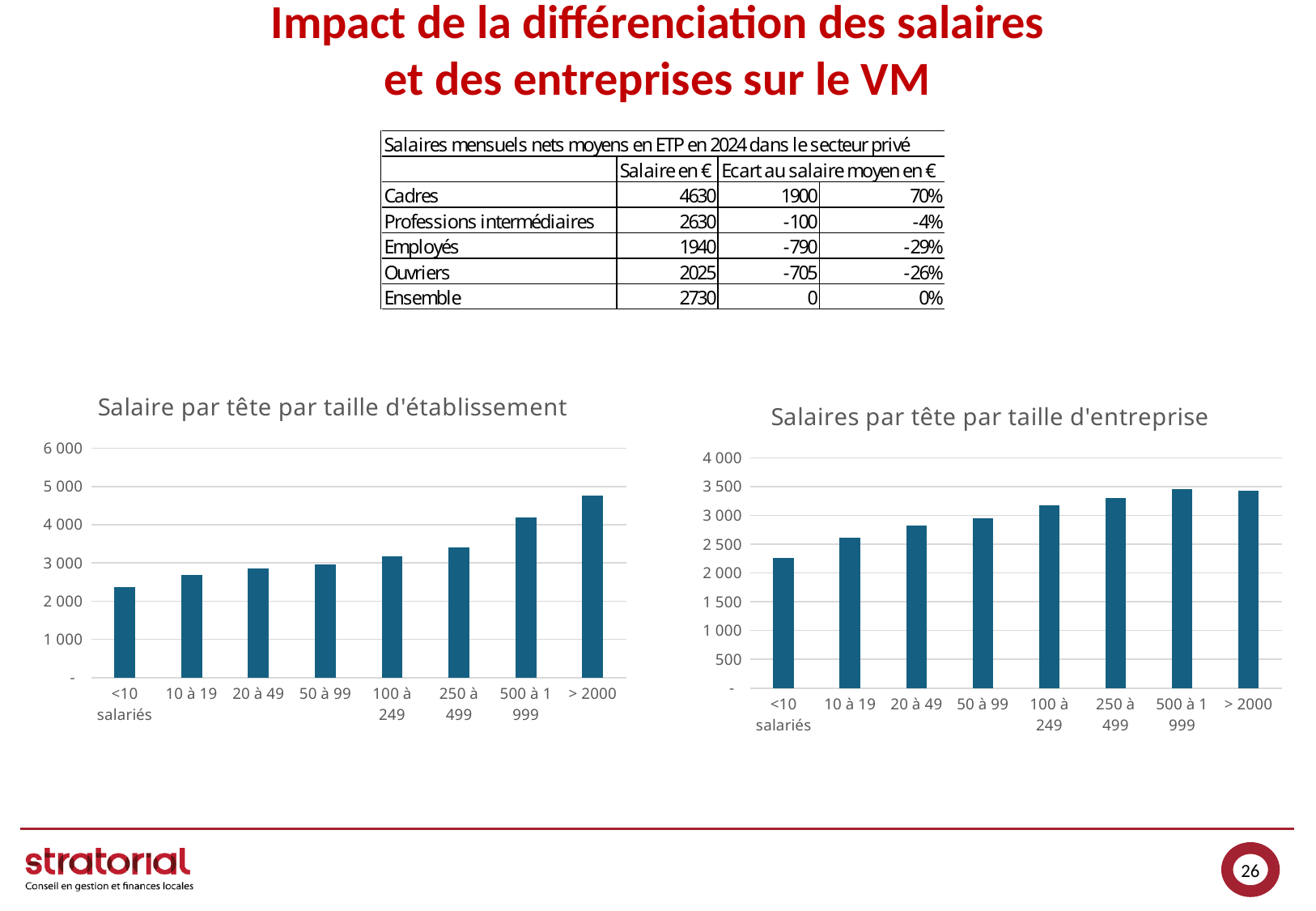
What kind of chart is the left chart titled "Salaire par tête par taille d'établissement"? bar chart In the right chart (Salaires par tête par taille d'entreprise), which category has the lowest bar? <10 salariés In the left chart (Salaire par tête par taille d'établissement), which category has the lowest bar? <10 salariés In the left chart (Salaire par tête par taille d'établissement), is the value for <10 salariés greater or less than 2 000? greater In the right chart (Salaires par tête par taille d'entreprise), which is larger, the value for 250 à 499 or the value for 10 à 19? 250 à 499 In the right chart (Salaires par tête par taille d'entreprise), is the value for 20 à 49 greater or less than 3 000? less How many size categories are shown on the x axis of the left chart (Salaire par tête par taille d'établissement)? 8 In the left chart (Salaire par tête par taille d'établissement), do the values rise or fall as establishment size increases along the x axis? rise In the left chart (Salaire par tête par taille d'établissement), which category has the highest bar? > 2000 In the right chart (Salaires par tête par taille d'entreprise), is the value for 500 à 1 999 greater or less than 3 000? greater What is the title of the right chart on the slide? Salaires par tête par taille d'entreprise